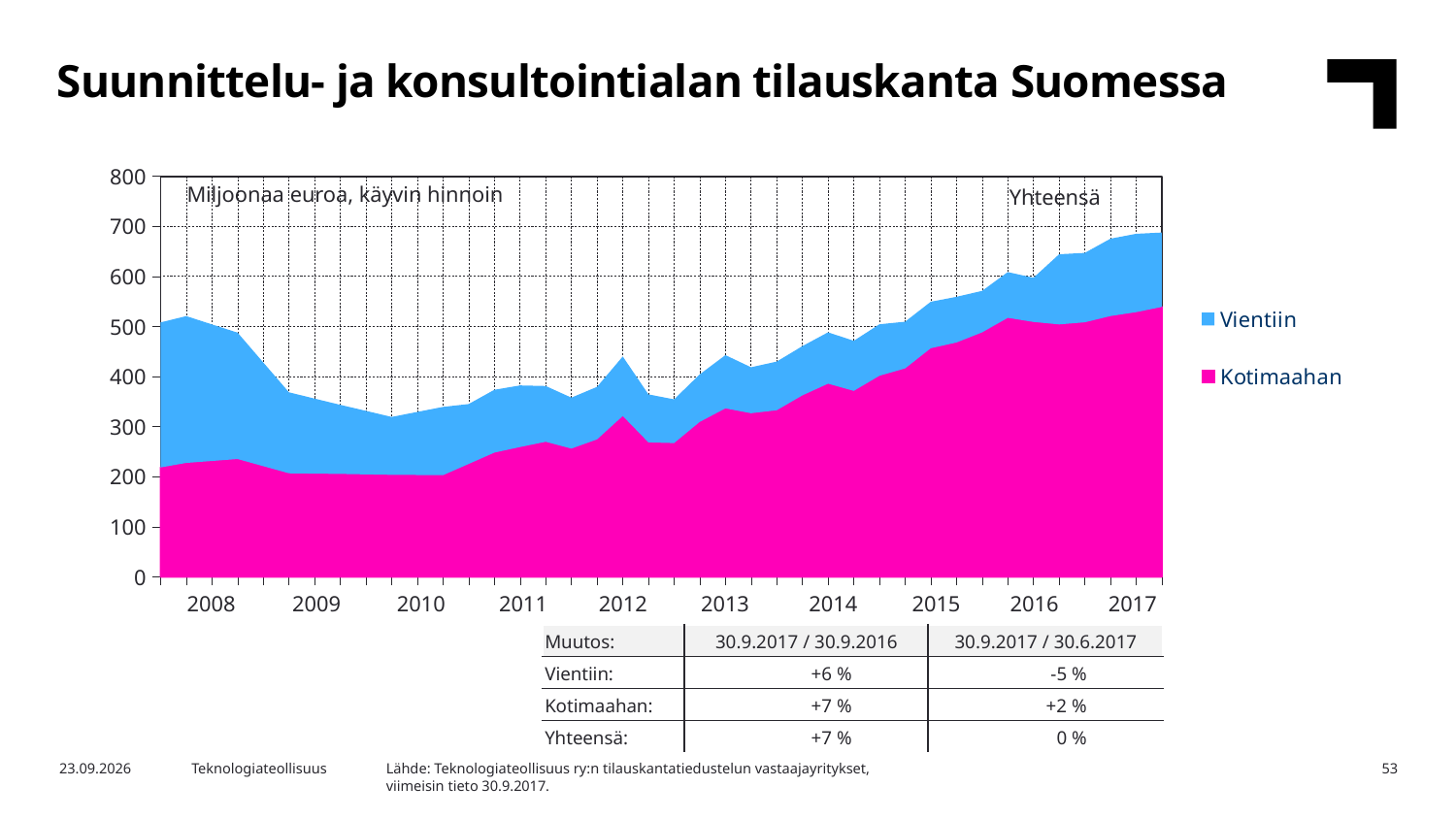
What kind of chart is shown on the slide? Stacked area chart What unit is stated in the chart's top-left label? Miljoonaa euroa, käyvin hinnoin Is the total (Yhteensä) value in 2010 greater or less than 400? less Does the Kotimaahan series rise or fall from 2013 to 2017? rise How many series does the legend list? 2 Is the Kotimaahan value at the end of 2017 greater or less than 500? greater According to the table below the chart, what is the change for Vientiin between 30.9.2016 and 30.9.2017? +6 % Is the Kotimaahan value in 2010 greater or less than 300? less How many year labels are shown on the x axis? 10 What are the two series named in the legend? Vientiin and Kotimaahan Does the total (Yhteensä) rise or fall from 2008 to 2010? fall